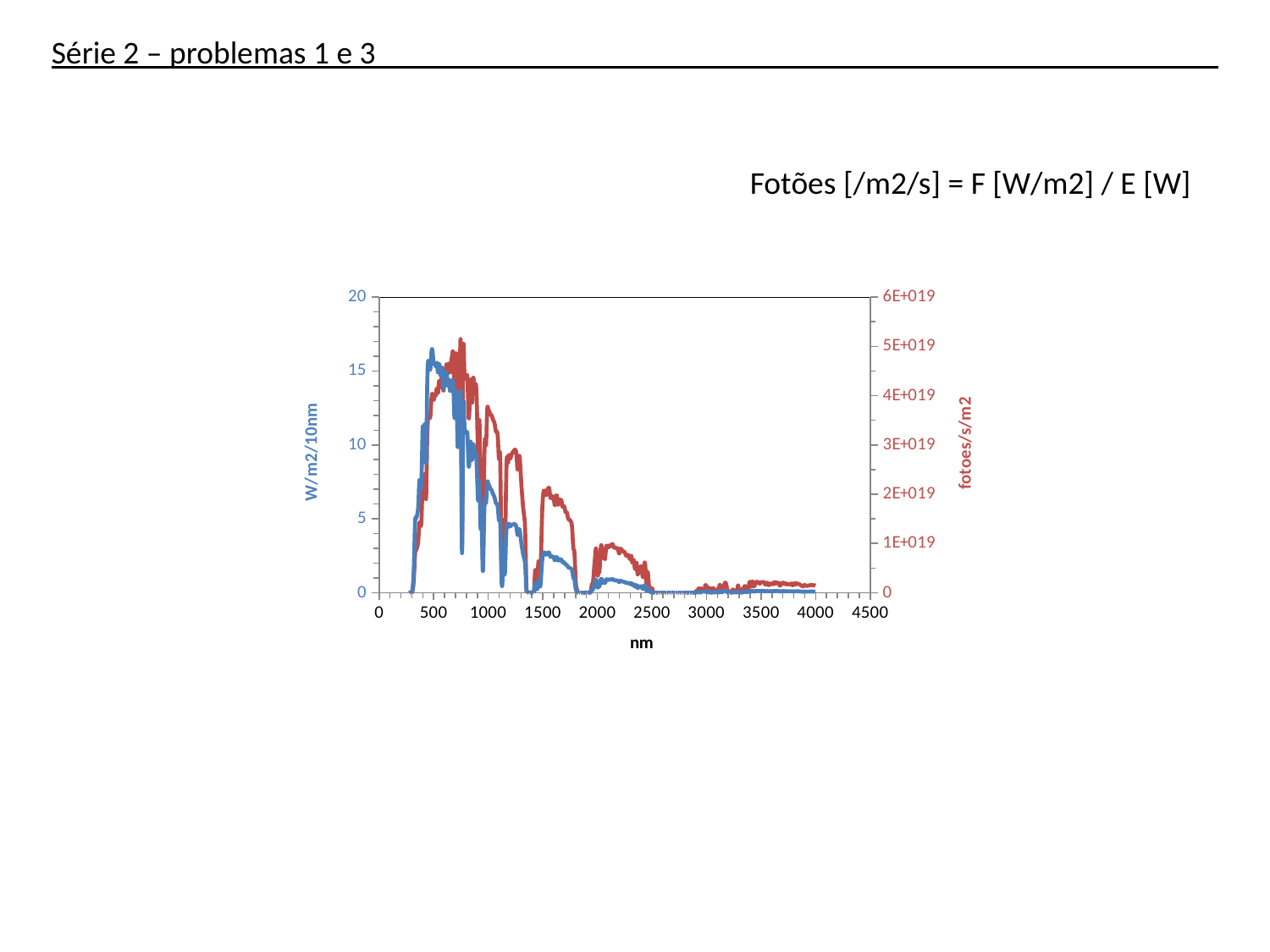
Is the value of the red fotoes/s/m2 series at 3500 nm greater or less than 1E+019? less What is the label of the x axis of the chart? nm What is the highest tick value shown on the left y axis (W/m2/10nm)? 20 How many data series are plotted on the chart? 2 After their peaks, do the plotted values generally rise or fall as the wavelength in nm increases? fall What is the label of the left (blue) y axis of the chart? W/m2/10nm What is the highest tick value shown on the right y axis (fotoes/s/m2)? 6E+019 Is the peak value of the blue W/m2/10nm series greater or less than 15? greater Is the value of the blue W/m2/10nm series at 1000 nm greater or less than 10? less What kind of chart is shown on the slide? line chart